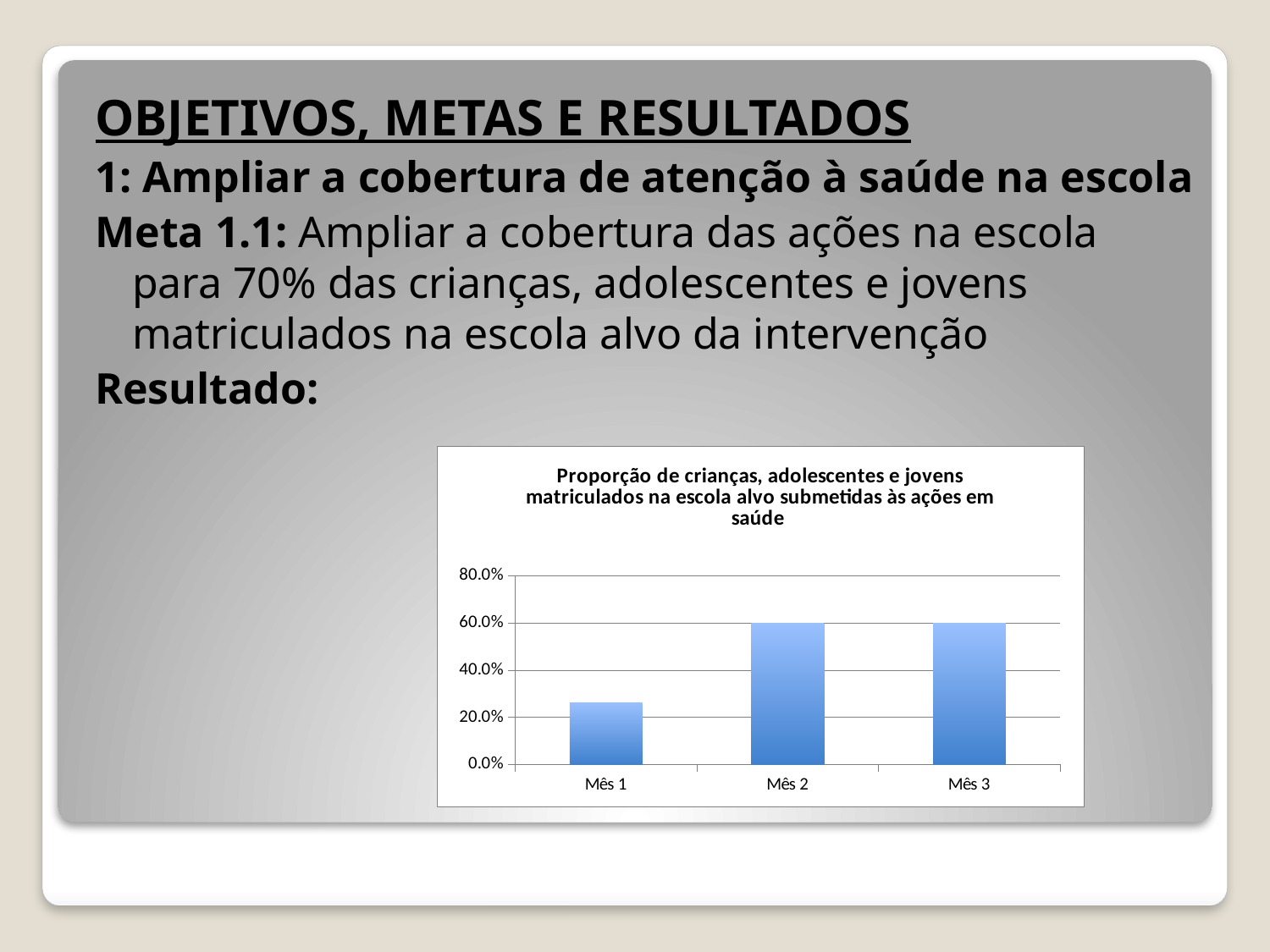
Is the value for Mês 3 greater or less than 80.0%? less Which month has the lowest value in the chart? Mês 1 Which is larger, the value for Mês 3 or the value for Mês 1? Mês 3 Which is larger, the value for Mês 1 or the value for Mês 2? Mês 2 Is the value for Mês 1 greater or less than 40.0%? less What kind of chart is shown on the slide? bar chart What is the highest value shown on the y axis of the chart? 80.0% Do the values rise or fall from Mês 1 to Mês 3? rise Is the value for Mês 2 greater or less than 40.0%? greater How many categories (months) are shown on the x axis of the chart? 3 What is the title of the chart? Proporção de crianças, adolescentes e jovens matriculados na escola alvo submetidas às ações em saúde